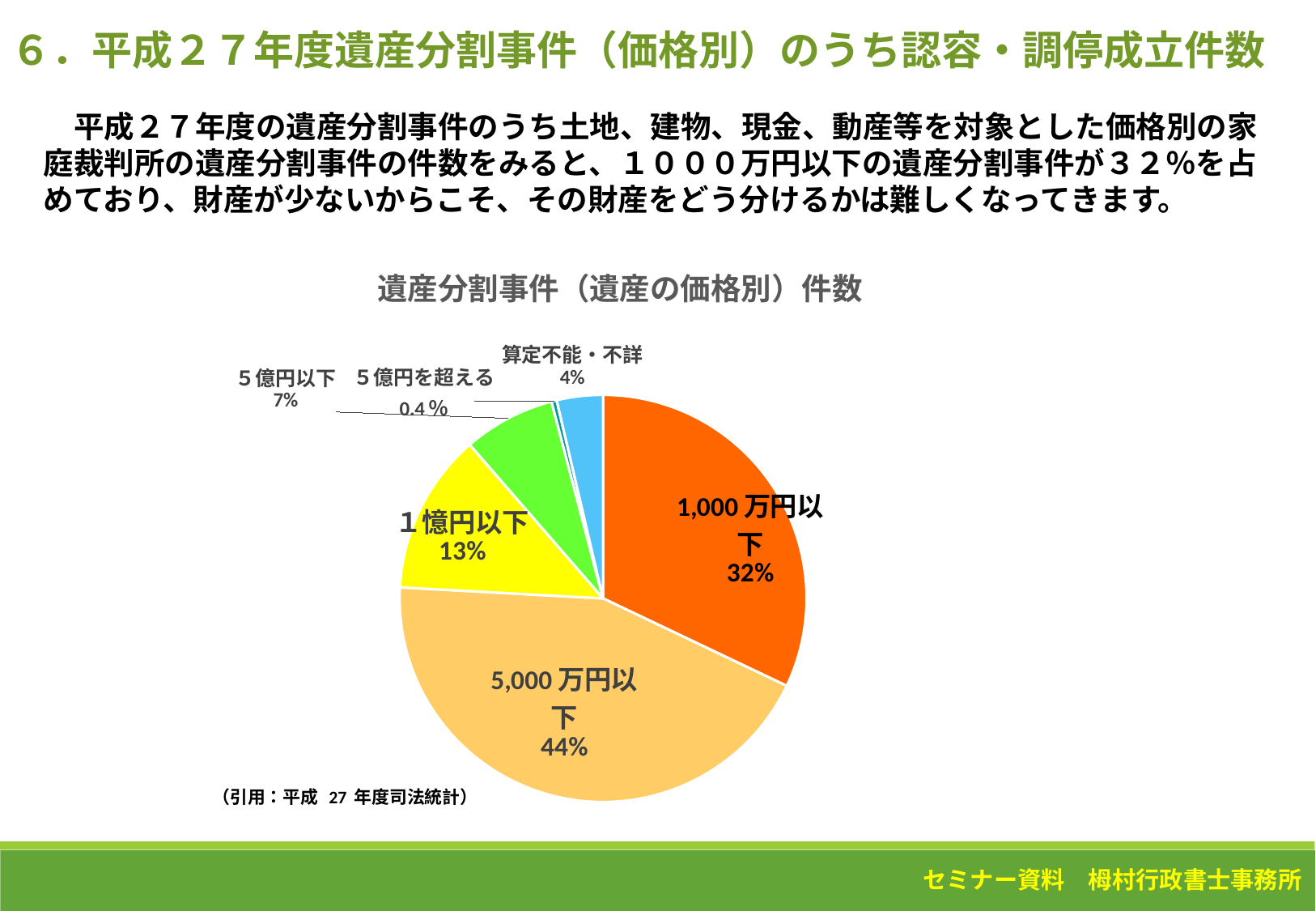
How many slices does the pie chart have? 6 What is the difference between the shares of 5,000万円以下 and 1,000万円以下? 12% What is the value shown for 5億円を超える? 0.4％ What share of the pie does 1,000万円以下 account for? 32% What kind of chart is shown on the slide? pie chart Which category has the smallest slice of the pie? 5億円を超える What share of the pie does 5,000万円以下 account for? 44% What is the value shown for 5億円以下? 7% What is the value shown for 1億円以下? 13% What is the value shown for 算定不能・不詳? 4% What is the title of the chart? 遺産分割事件（遺産の価格別）件数 Which category has the largest slice of the pie? 5,000万円以下